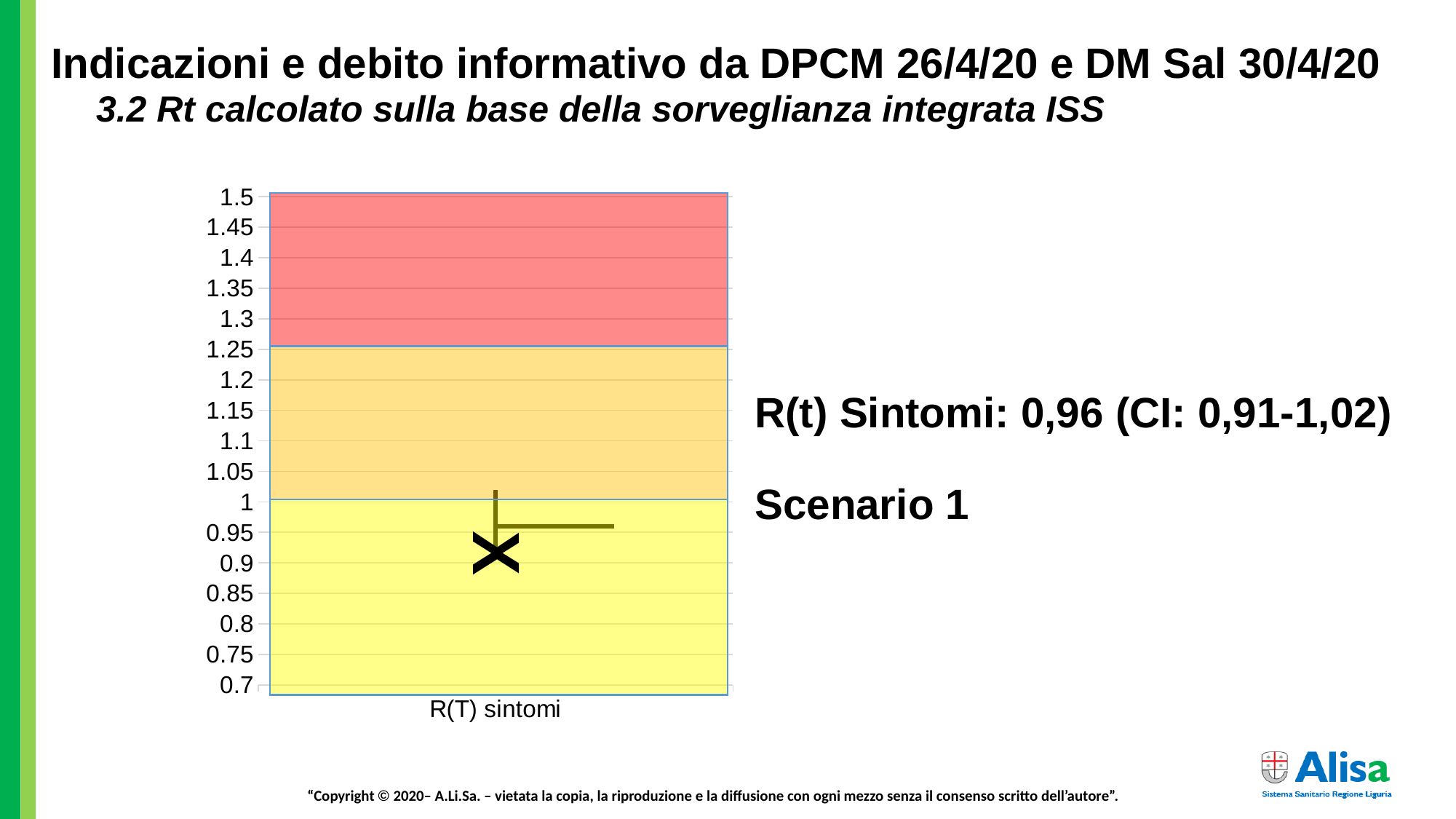
What is the highest value shown on the chart's y axis? 1.5 What is the label of the category on the x axis of the chart? R(T) sintomi What is the lowest value shown on the chart's y axis? 0.7 What R(t) Sintomi value is stated in the text next to the chart? 0,96 Which scenario is stated next to the chart? Scenario 1 Is the plotted value for R(T) sintomi greater or less than 1? less Is the plotted value for R(T) sintomi greater or less than 0.8? greater How many categories are shown on the x axis of the chart? 1 What confidence interval (CI) is stated for R(t) Sintomi on the slide? 0,91-1,02 Is the plotted value for R(T) sintomi greater or less than 1.25? less